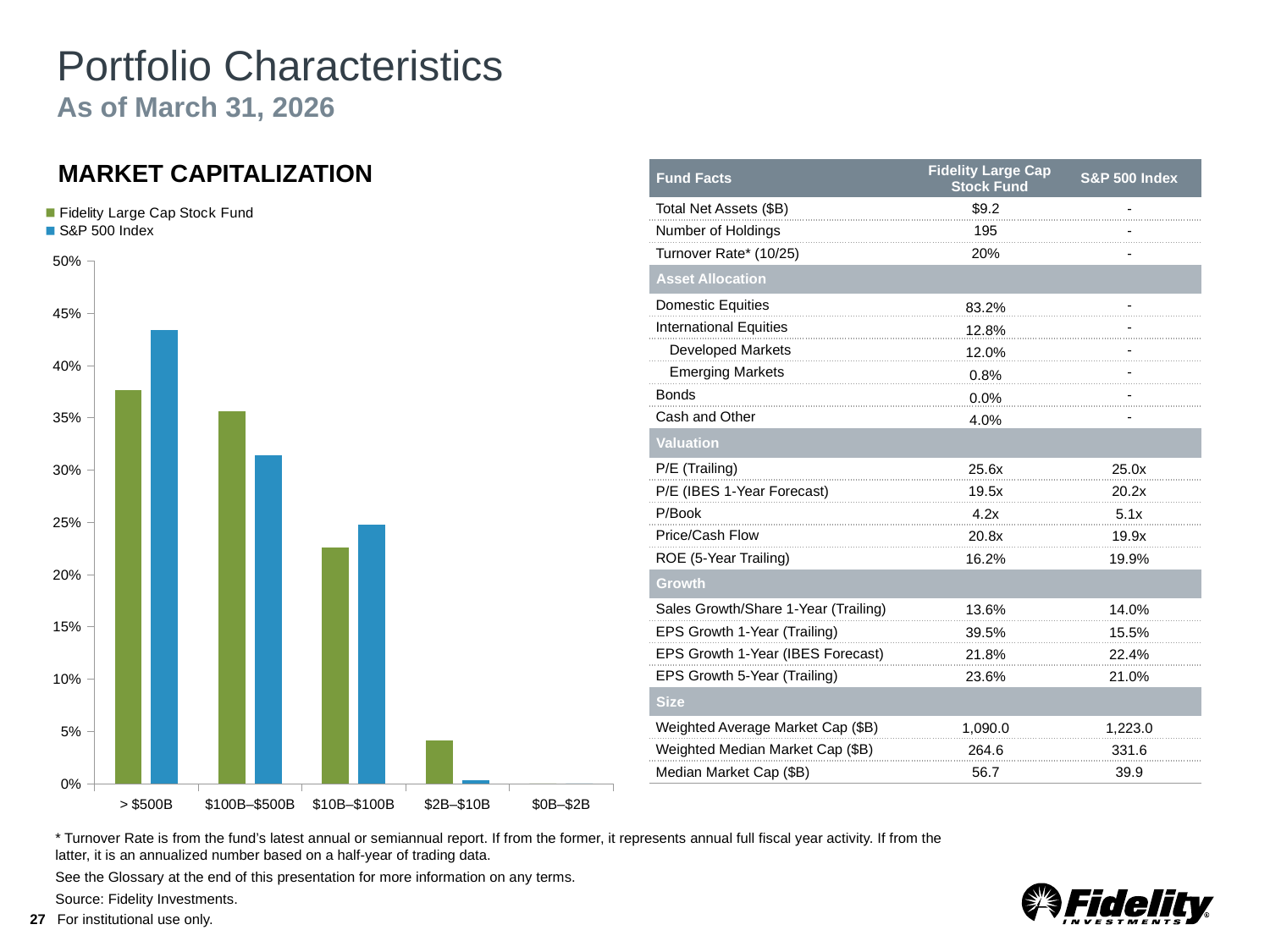
In the Market Capitalization chart, which category has the highest value for the S&P 500 Index? > $500B In the Market Capitalization chart, for the > $500B category, which series has the larger value: Fidelity Large Cap Stock Fund or S&P 500 Index? S&P 500 Index How many series does the legend of the Market Capitalization chart list? 2 In the Market Capitalization chart, is the Fidelity Large Cap Stock Fund value for $2B–$10B greater or less than 5%? less In the Market Capitalization chart, for the $100B–$500B category, which series has the larger value: Fidelity Large Cap Stock Fund or S&P 500 Index? Fidelity Large Cap Stock Fund How many market-cap categories are shown on the x axis of the Market Capitalization chart? 5 In the Market Capitalization chart, is the S&P 500 Index value for > $500B greater or less than 40%? greater In the Market Capitalization chart, which colour represents the S&P 500 Index? blue In the Market Capitalization chart, which category has the highest value for the Fidelity Large Cap Stock Fund? > $500B What kind of chart is shown under the heading MARKET CAPITALIZATION? bar chart In the Market Capitalization chart, is the Fidelity Large Cap Stock Fund value for $10B–$100B greater or less than 25%? less In the Market Capitalization chart, which category has the lowest value for the Fidelity Large Cap Stock Fund? $0B–$2B